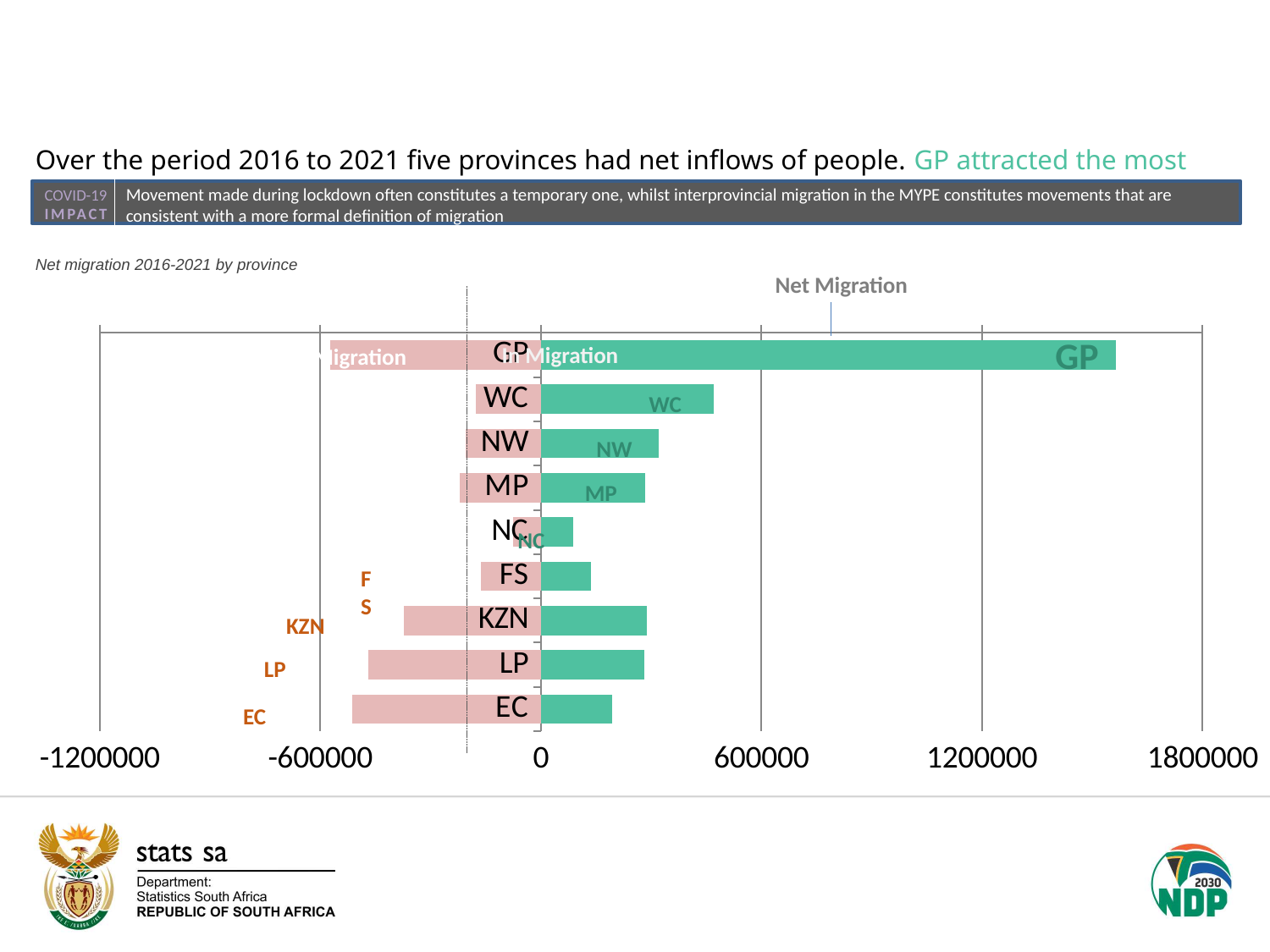
Which has the longer pink (negative) bar, LP or KZN? LP Which has the larger green bar, WC or NC? WC Which province has the largest green (positive net migration) bar? GP Is the green bar value for WC greater or less than 600000? less Which has the larger green bar, GP or WC? GP Which province has the shortest green bar? NC What is the title of the chart? Net migration 2016-2021 by province What kind of chart is shown on the slide? bar chart How many provinces are shown on the chart? 9 Is the green bar value for GP greater or less than 1200000? greater What is the highest value shown on the horizontal axis? 1800000